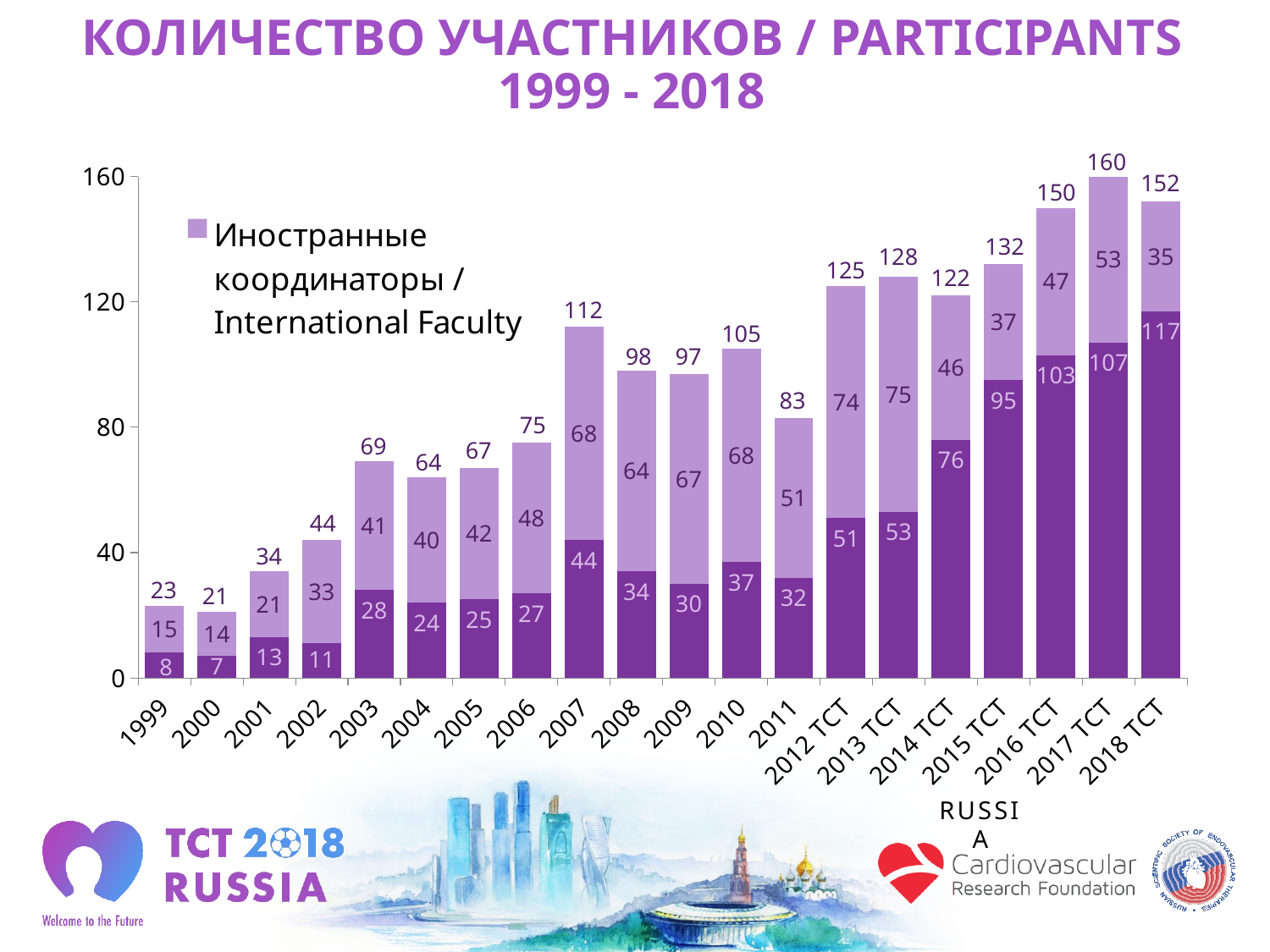
Which is larger, the International Faculty value for 2012 TCT or for 2014 TCT? 2012 TCT What is the English name of the series shown in the legend? International Faculty What is the total number of participants for 2017 TCT? 160 What kind of chart is shown on the slide? Stacked bar chart What is the International Faculty value for 2007? 68 Do the total participant numbers generally rise or fall from 1999 to 2018 TCT? Rise Which year has the highest total number of participants? 2017 TCT Which year has the lowest total number of participants? 2000 What is the difference between the total for 2017 TCT and the total for 2018 TCT? 8 What is the value of the dark purple (bottom) segment for 2018 TCT? 117 How many years (categories) are shown along the x axis? 20 Is the total for 2011 greater or less than 80? greater